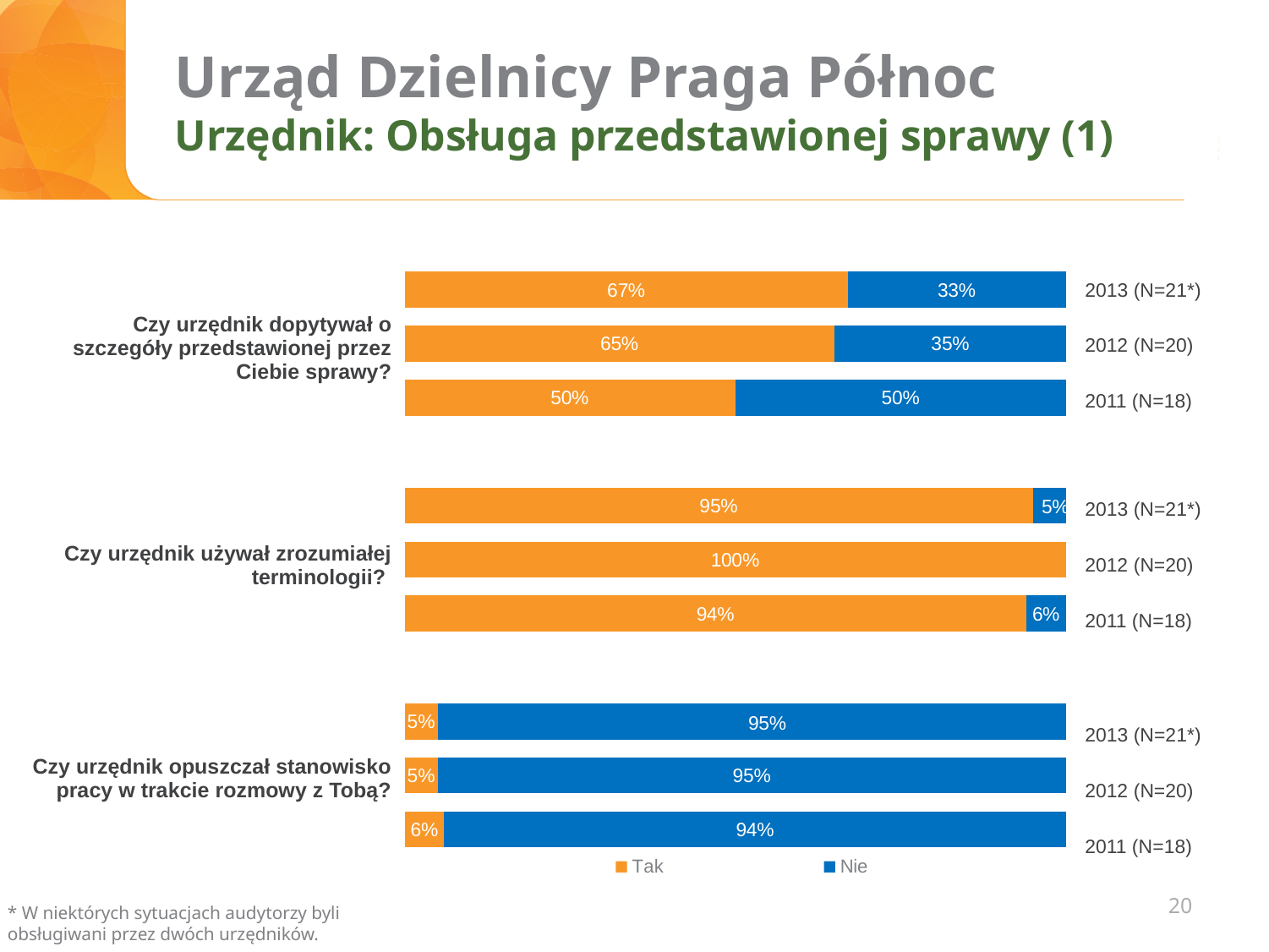
What percentage answered "Nie" in 2011 (N=18) for the question "Czy urzędnik używał zrozumiałej terminologii?"? 6% For the question "Czy urzędnik dopytywał o szczegóły przedstawionej przez Ciebie sprawy?", which year has the highest "Tak" share? 2013 (N=21*) What percentage answered "Tak" in 2013 (N=21*) for the question "Czy urzędnik dopytywał o szczegóły przedstawionej przez Ciebie sprawy?"? 67% Which colour represents the "Nie" answers in the chart? Blue What type of chart is shown on the slide? Stacked bar chart For the question "Czy urzędnik opuszczał stanowisko pracy w trakcie rozmowy z Tobą?" in 2011 (N=18), which is larger: the "Tak" share or the "Nie" share? Nie What is the difference between the "Tak" share in 2013 and in 2011 for the question "Czy urzędnik dopytywał o szczegóły przedstawionej przez Ciebie sprawy?"? 17 percentage points What percentage answered "Tak" in 2012 (N=20) for the question "Czy urzędnik używał zrozumiałej terminologii?"? 100% What percentage answered "Nie" in 2012 (N=20) for the question "Czy urzędnik dopytywał o szczegóły przedstawionej przez Ciebie sprawy?"? 35% What percentage answered "Tak" in 2013 (N=21*) for the question "Czy urzędnik opuszczał stanowisko pracy w trakcie rozmowy z Tobą?"? 5% For the question "Czy urzędnik używał zrozumiałej terminologii?", which year has the lowest "Tak" share? 2011 (N=18) How many series does the legend list? 2